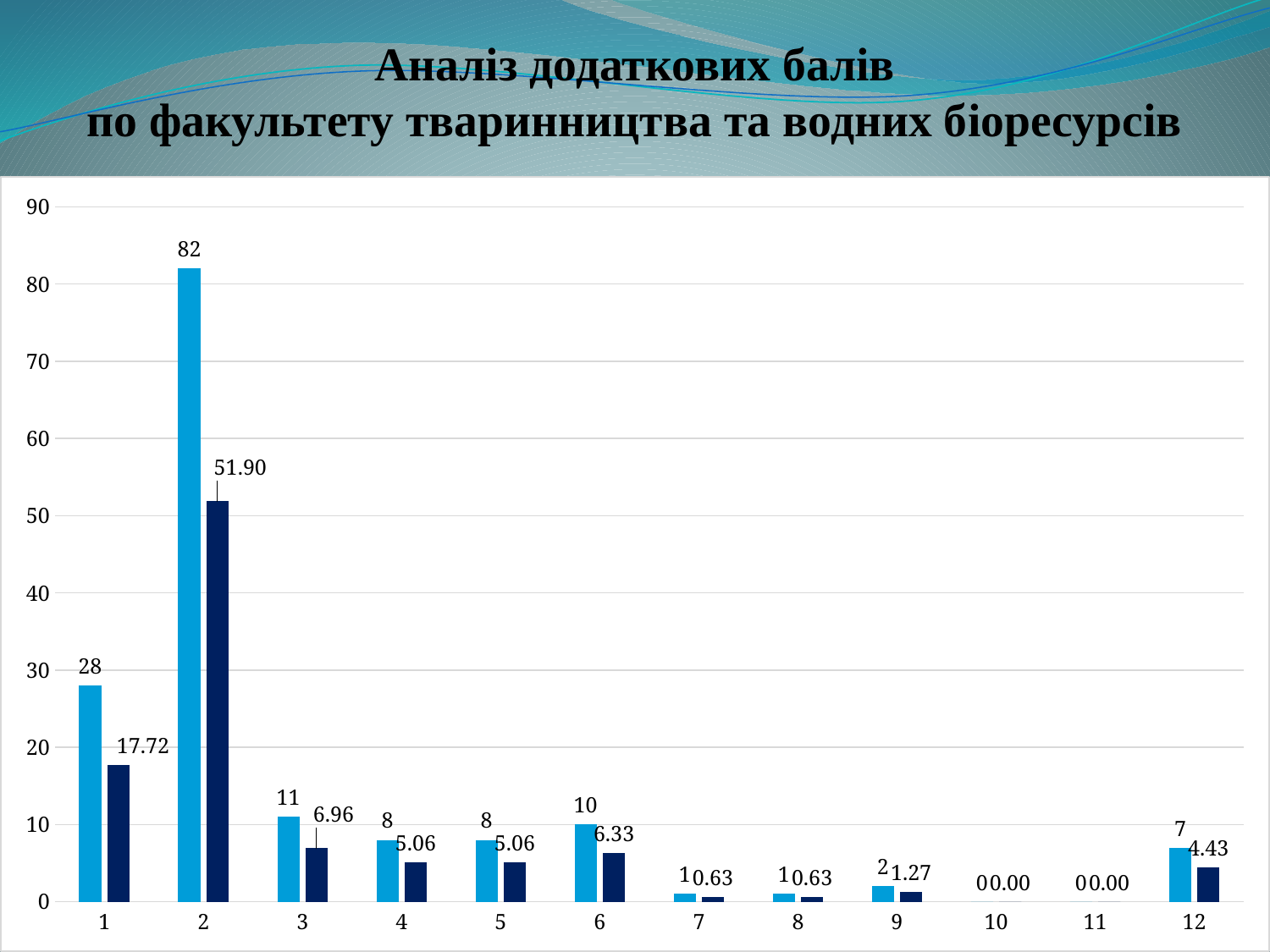
What is the difference between the light blue values for categories 2 and 1? 54 Which category has the highest light blue bar? 2 Which is larger: the light blue bar for category 3 or the light blue bar for category 12? category 3 How many categories are shown on the x axis? 12 What is the title of the chart on the slide? Аналіз додаткових балів по факультету тваринництва та водних біоресурсів Is the value of the dark blue bar for category 2 greater or less than 50? greater Which category has the highest dark blue bar? 2 What is the value of the light blue bar for category 6? 10 What is the value of the light blue bar for category 2? 82 What is the value of the dark blue bar for category 12? 4.43 What kind of chart is shown on the slide? bar chart What is the value of the dark blue bar for category 1? 17.72